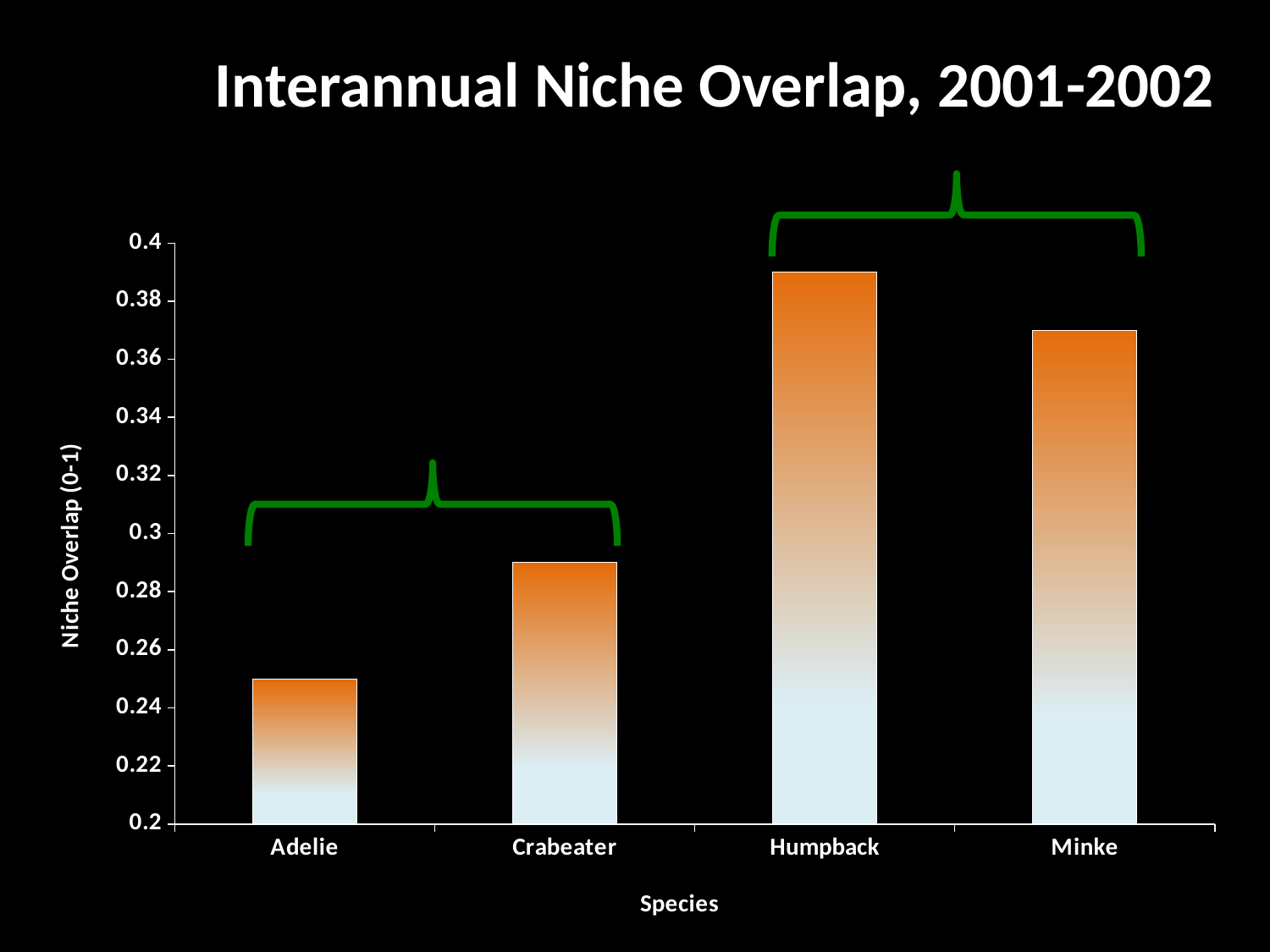
Is the value for Crabeater greater or less than 0.3? less Is the value for Adelie greater or less than 0.3? less Is the value for Minke greater or less than 0.34? greater What kind of chart is shown on the slide? bar chart Which species has the lowest niche overlap? Adelie Which has a higher niche overlap, Humpback or Minke? Humpback What is the label of the y axis? Niche Overlap (0-1) Which species has the highest niche overlap? Humpback What is the title of the chart? Interannual Niche Overlap, 2001-2002 How many species are shown on the x axis? 4 Which has a higher niche overlap, Adelie or Crabeater? Crabeater